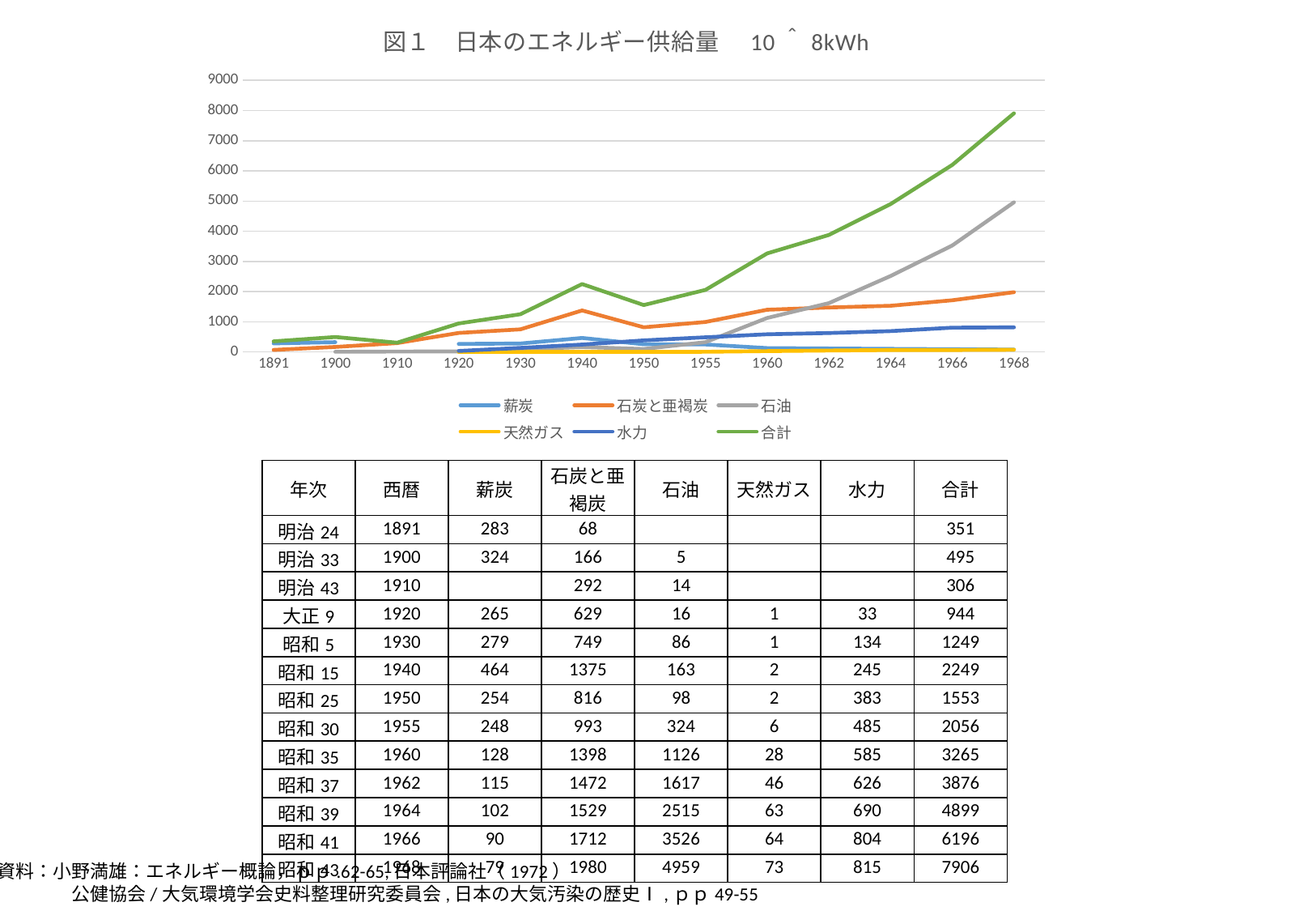
What is the value of 石油 (oil) in 1960? 1126 In which year does the 合計 (total) series reach its highest value? 1968 In which year is the 合計 (total) series at its lowest value? 1910 Does the 薪炭 (firewood and charcoal) series rise or fall between 1940 and 1968? fall What is the value of 水力 (hydro) in 1940? 245 Which is larger in 1962, 石油 (oil) or 石炭と亜褐炭 (coal and lignite)? 石油 Is the value of 合計 (total) in 1966 greater or less than 6000? greater What is the value of 合計 (total) in 1968? 7906 How many series does the chart legend list? 6 What is the difference between 石油 (oil) and 石炭と亜褐炭 (coal and lignite) in 1968? 2979 How many years are plotted along the x axis of the chart? 13 What type of chart is shown on the slide? line chart